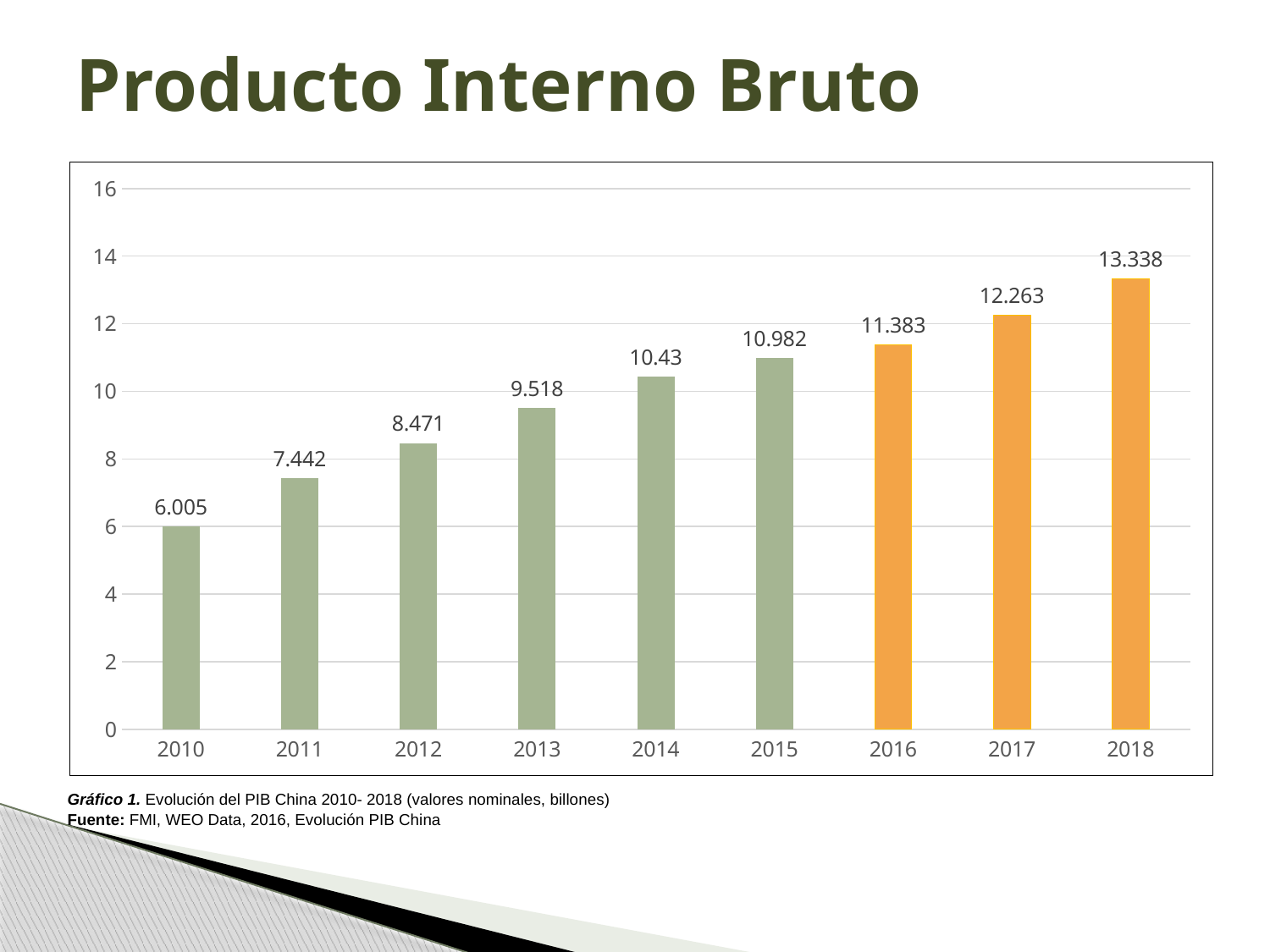
Is the value for 2012 greater or less than 10? less What is the value shown for 2014? 10.43 What is the difference between the values for 2018 and 2010? 7.333 How many years are shown on the x axis? 9 What is the difference between the values for 2017 and 2016? 0.88 Do the values rise or fall from 2010 to 2018? rise What is the value shown for 2010? 6.005 Which is larger, the value for 2013 or the value for 2015? 2015 Which year has the lowest value? 2010 What kind of chart is shown on the slide? bar chart Which year has the highest value? 2018 What is the value shown for 2017? 12.263